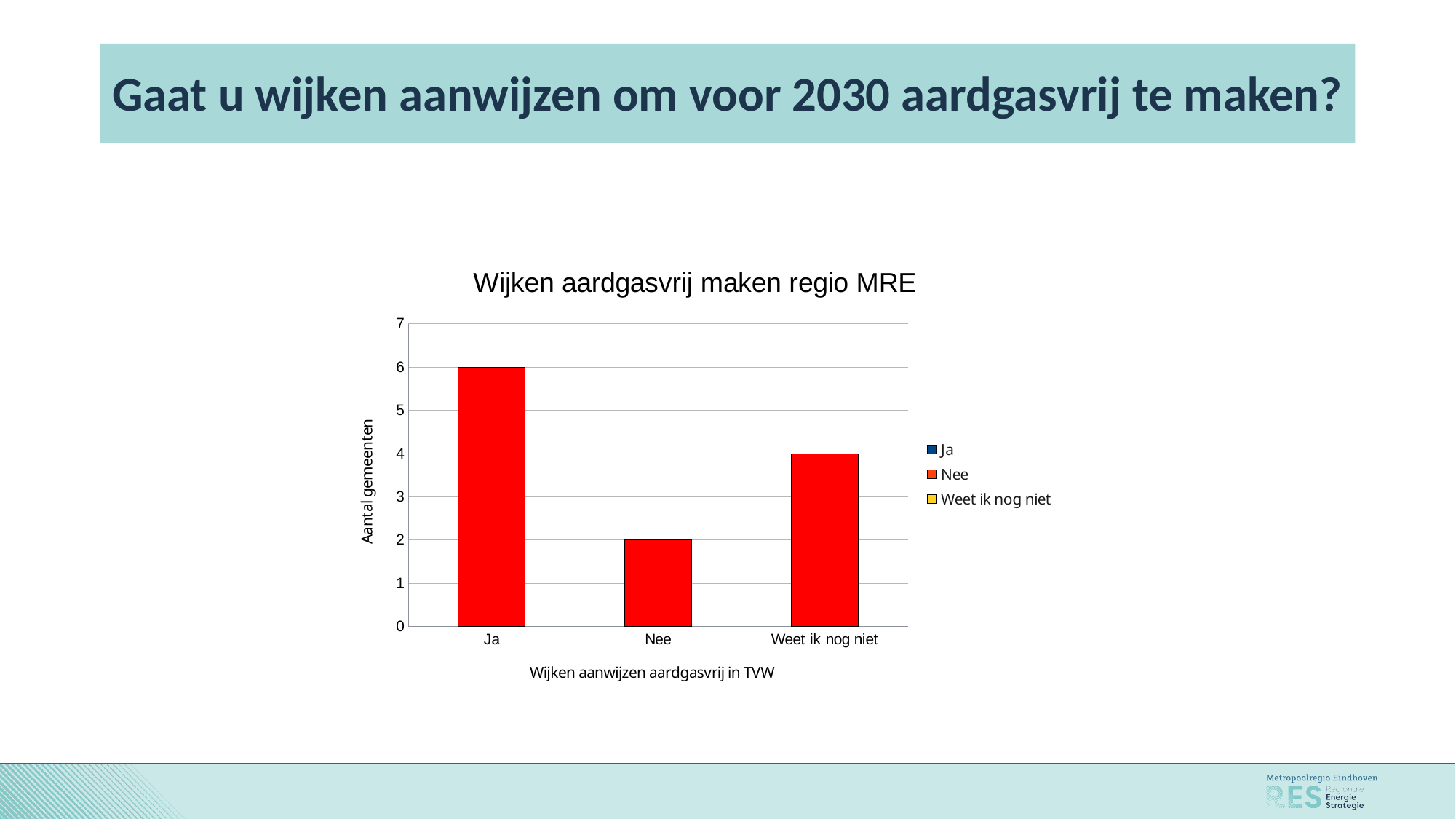
Is the value for Ja greater or less than 5? greater What is the difference between the values for Ja and Nee? 4 What is the difference between the values for Weet ik nog niet and Nee? 2 What is the value for Weet ik nog niet in the chart? 4 How many entries does the legend list? 3 Which category has the highest value? Ja How many categories are shown on the x axis? 3 What is the value for Nee in the chart? 2 Which is larger, the value for Weet ik nog niet or the value for Nee? Weet ik nog niet What is the value for Ja in the chart? 6 Which category has the lowest value? Nee What kind of chart is shown on the slide? bar chart